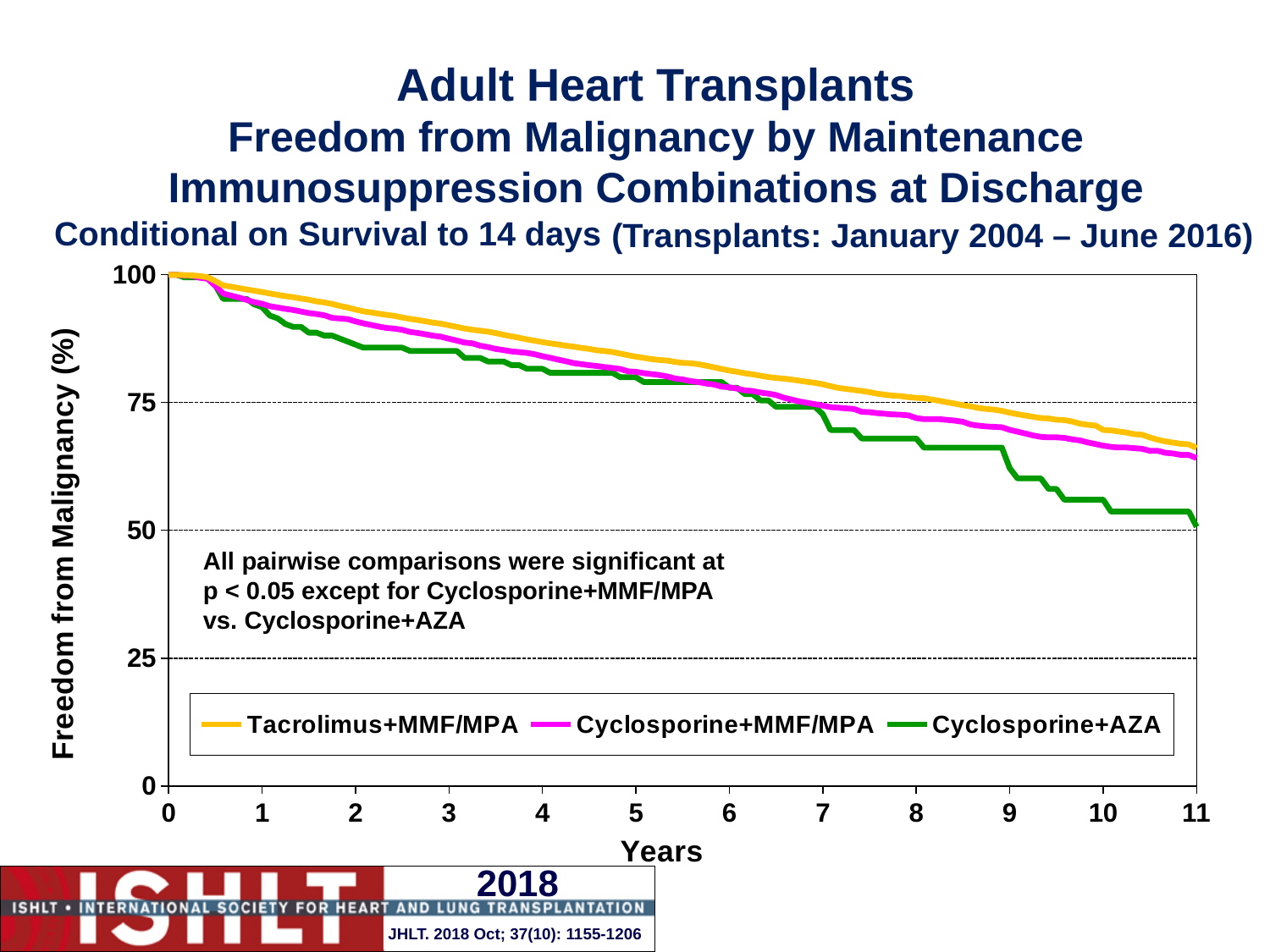
How many series does the legend list? 3 Do the values for Tacrolimus+MMF/MPA rise or fall as years increase? Fall At 3 years, which is higher: Cyclosporine+MMF/MPA or Cyclosporine+AZA? Cyclosporine+MMF/MPA Is the value for Cyclosporine+AZA at 10 years greater or less than 75? less At 10 years, which is higher: Tacrolimus+MMF/MPA or Cyclosporine+AZA? Tacrolimus+MMF/MPA Which series is shown in green in the legend? Cyclosporine+AZA What kind of chart is shown on the slide? Line chart Is the value for Tacrolimus+MMF/MPA at 5 years greater or less than 75? greater Which series has the lowest freedom from malignancy at 10 years? Cyclosporine+AZA Is the value for Cyclosporine+AZA at 9 years greater or less than 50? greater What is the label of the y axis? Freedom from Malignancy (%)